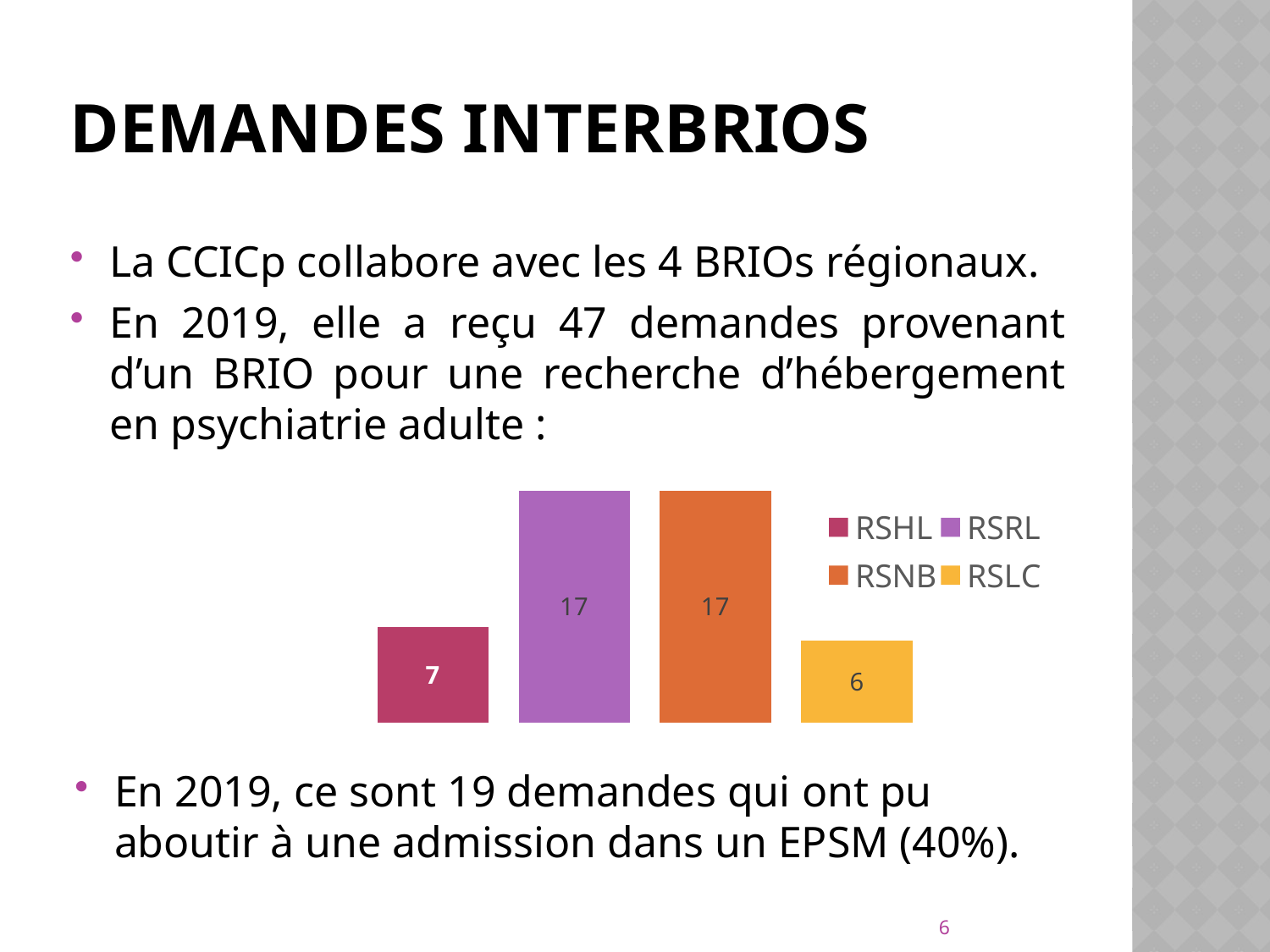
What is the value for RSNB in the bar chart? 17 How many series does the legend list? 4 Which is larger, the value for RSHL or the value for RSNB? RSNB What is the difference between the values for RSHL and RSLC? 1 How many bars are plotted in the chart? 4 What is the value for RSRL in the bar chart? 17 What is the value for RSHL in the bar chart? 7 What kind of chart is shown on the slide? Bar chart What is the difference between the values for RSRL and RSLC? 11 Which series has the lowest value in the bar chart? RSLC What colour is the RSNB bar in the chart? Orange What is the value for RSLC in the bar chart? 6